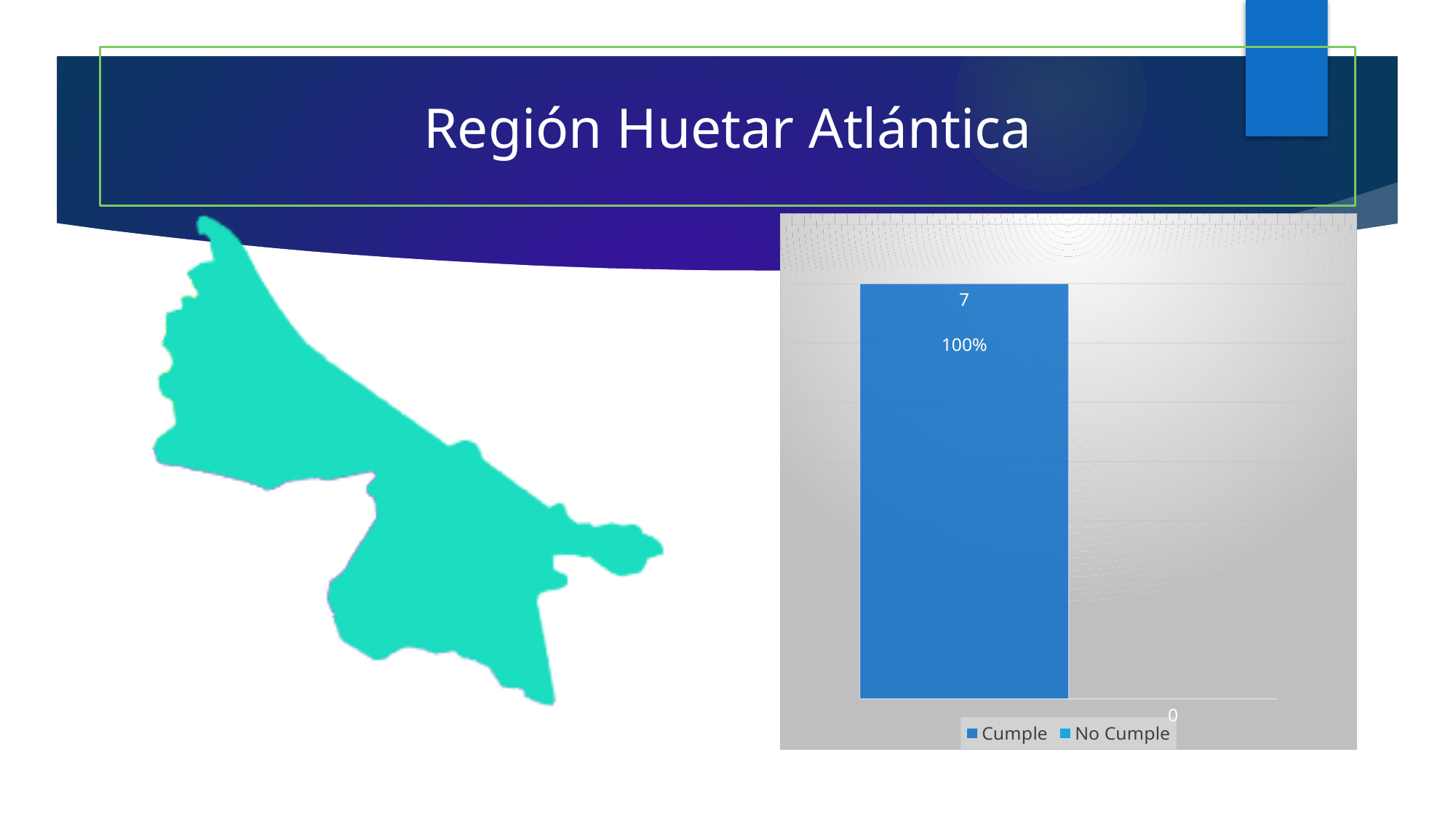
What is the title of the slide containing the chart? Región Huetar Atlántica Which series has the lowest value in the chart? No Cumple How many series does the chart legend list? 2 What is the value shown for Cumple in the chart? 7 What percentage is shown on the Cumple bar? 100% What is the total of the Cumple and No Cumple values? 7 What kind of chart is shown on the slide? bar chart What is the value shown for No Cumple in the chart? 0 What are the two series named in the chart legend? Cumple and No Cumple Which series has the highest value in the chart? Cumple What is the difference between the Cumple value and the No Cumple value? 7 Which series has the higher value, Cumple or No Cumple? Cumple